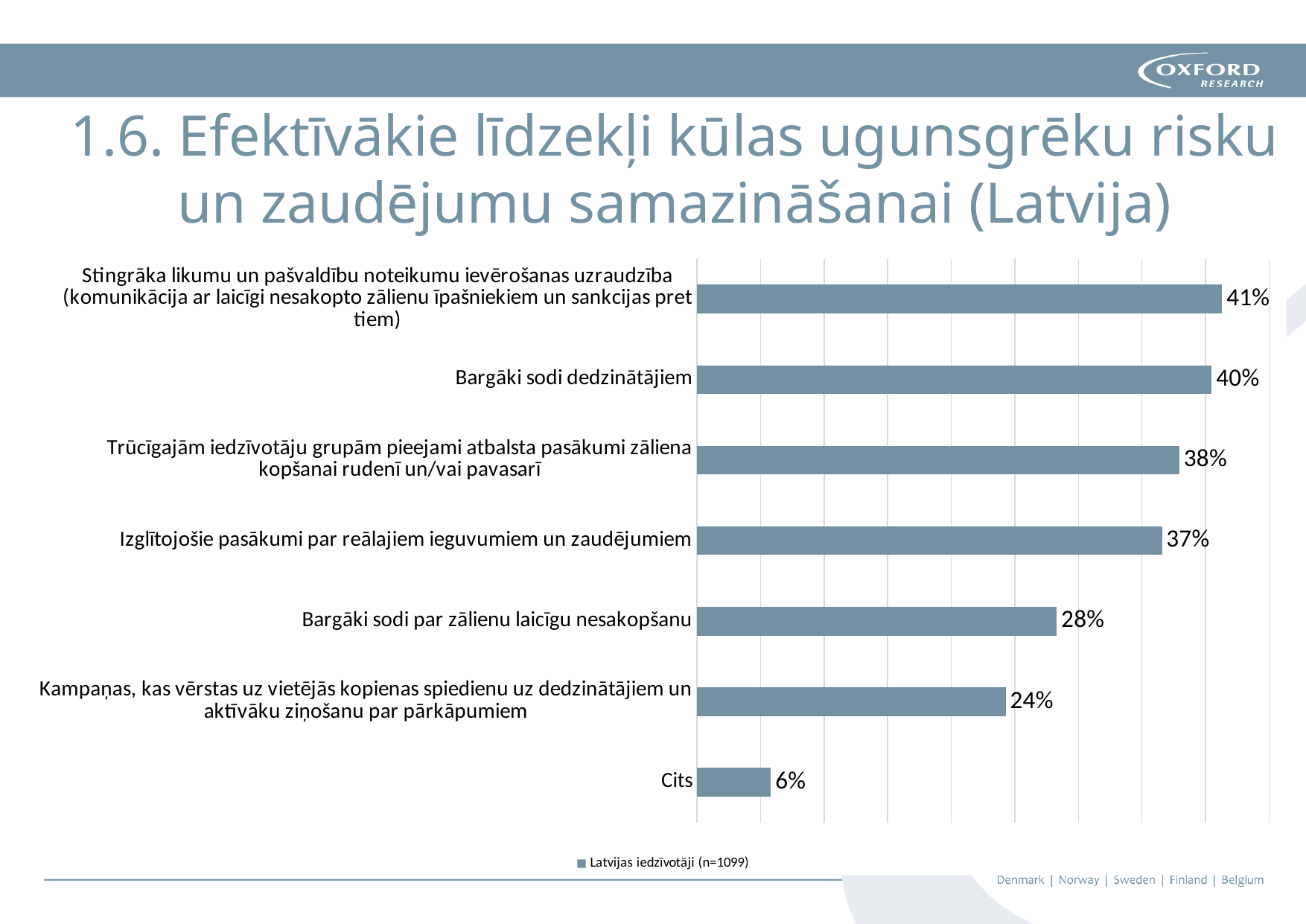
What is the value for "Izglītojošie pasākumi par reālajiem ieguvumiem un zaudējumiem"? 37% Which category has the lowest value? Cits What is the value for "Bargāki sodi dedzinātājiem"? 40% Which is larger: the value for "Trūcīgajām iedzīvotāju grupām pieejami atbalsta pasākumi zāliena kopšanai rudenī un/vai pavasarī" or for "Bargāki sodi par zālienu laicīgu nesakopšanu"? Trūcīgajām iedzīvotāju grupām pieejami atbalsta pasākumi zāliena kopšanai rudenī un/vai pavasarī What is the difference between the values for "Bargāki sodi par zālienu laicīgu nesakopšanu" and "Kampaņas, kas vērstas uz vietējās kopienas spiedienu uz dedzinātājiem un aktīvāku ziņošanu par pārkāpumiem"? 4% How many categories are shown in the chart? 7 What kind of chart is shown on the slide? Bar chart What is the value for "Bargāki sodi par zālienu laicīgu nesakopšanu"? 28% How many series does the legend list? 1 What is the legend entry of the chart? Latvijas iedzīvotāji (n=1099) Which category has the highest value? Stingrāka likumu un pašvaldību noteikumu ievērošanas uzraudzība (komunikācija ar laicīgi nesakopto zālienu īpašniekiem un sankcijas pret tiem) What is the value for "Cits"? 6%